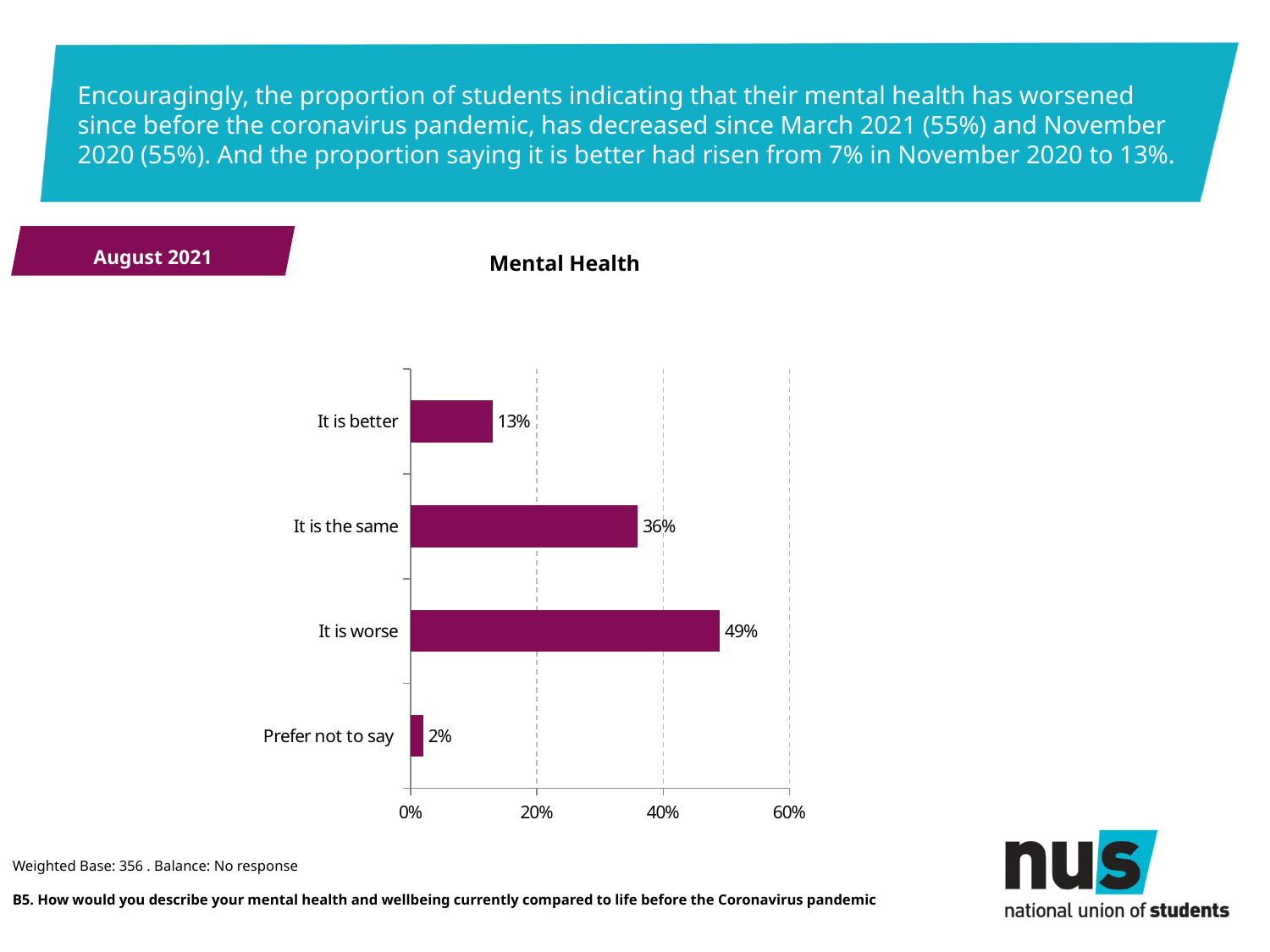
How many categories are shown in the chart? 4 What is the value for 'It is the same'? 36% What kind of chart is shown? Bar chart What is the value for 'It is better'? 13% What is the value for 'It is worse'? 49% What is the title of the chart? Mental Health Is the value for 'It is worse' greater or less than 40%? greater What is the value for 'Prefer not to say'? 2% Which category has the highest value? It is worse Which category has the lowest value? Prefer not to say What is the difference between 'It is worse' and 'It is the same'? 13% Which is larger, 'It is better' or 'It is the same'? It is the same